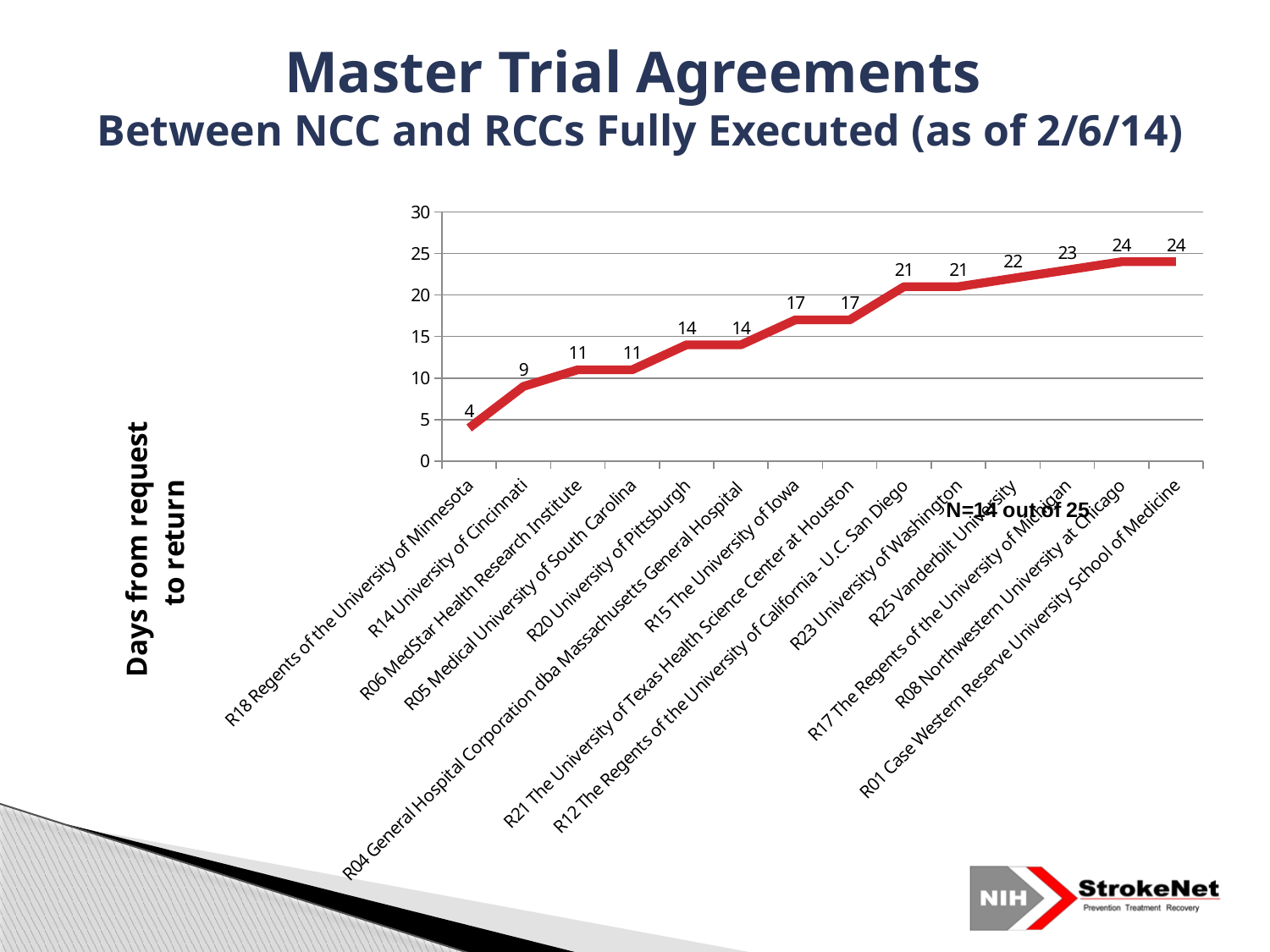
What is the value plotted for R23 University of Washington? 21 What is the label on the vertical axis of the chart? Days from request to return How many days from request to return are shown for R18 Regents of the University of Minnesota? 4 What is the value plotted for R14 University of Cincinnati? 9 Which institution has the lowest number of days from request to return? R18 Regents of the University of Minnesota What is the difference in days between R25 Vanderbilt University and R15 The University of Iowa? 5 What is the value plotted for R20 University of Pittsburgh? 14 Do the values generally rise or fall from left to right along the x axis? Rise What type of chart is shown on the slide? Line chart Which has a larger value: R06 MedStar Health Research Institute or R17 The Regents of the University of Michigan? R17 The Regents of the University of Michigan How many institutions are plotted on the chart? 14 What is the value plotted for R01 Case Western Reserve University School of Medicine? 24